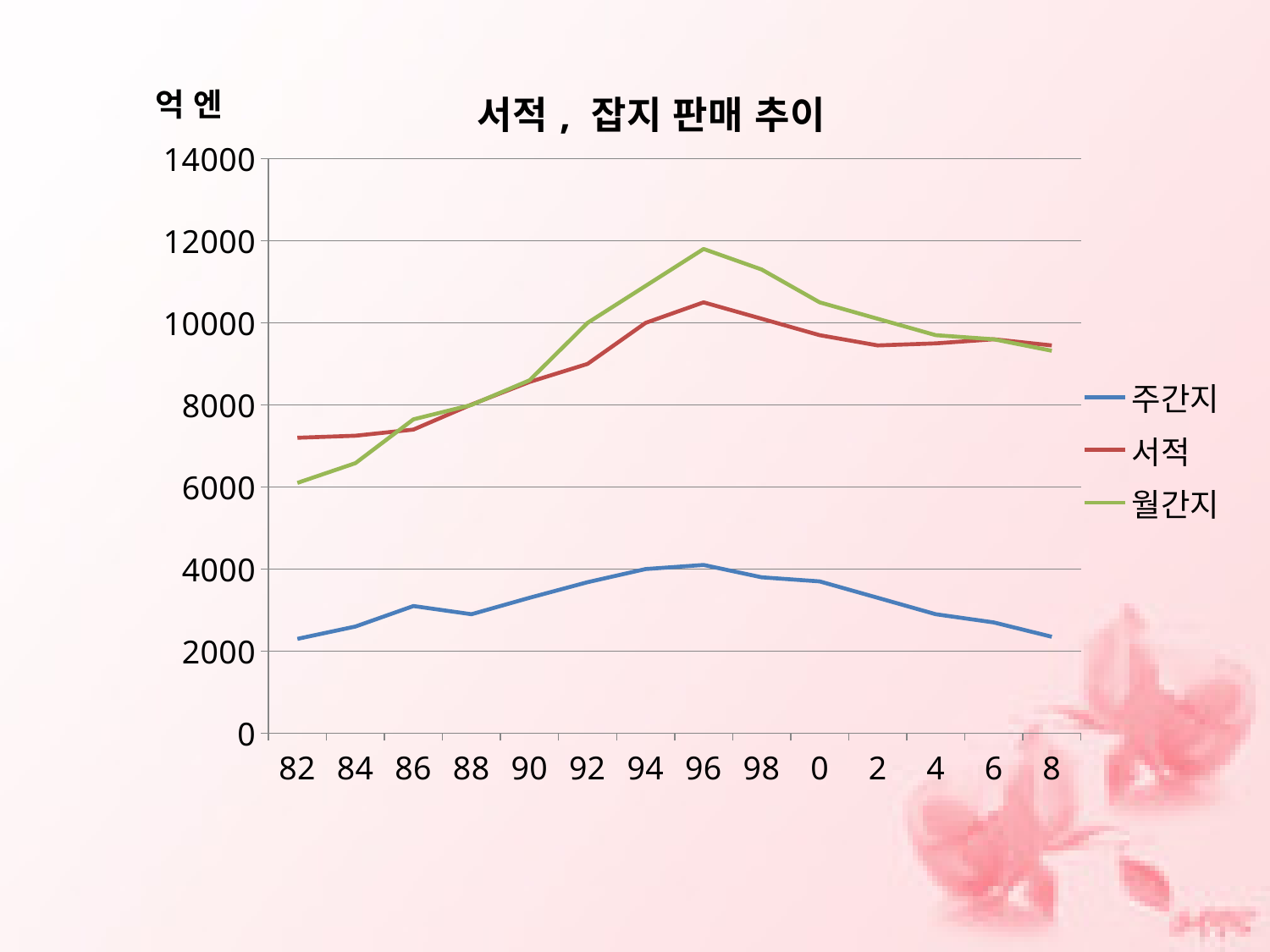
At 82, which is larger, 서적 or 월간지? 서적 Which series has the lowest values across the whole chart? 주간지 At 96, which is larger, 월간지 or 서적? 월간지 What is the title of the chart? 서적 , 잡지 판매 추이 How many points are plotted along the x axis for each series? 14 Does the 주간지 series rise or fall from 96 to 8? fall What kind of chart is shown on the slide? line chart What unit label is shown above the y axis? 억 엔 Is the value for 월간지 at 96 greater or less than 10000? greater In which year does the 월간지 series reach its highest value? 96 Is the value for 주간지 at 82 greater or less than 4000? less How many series does the legend list? 3